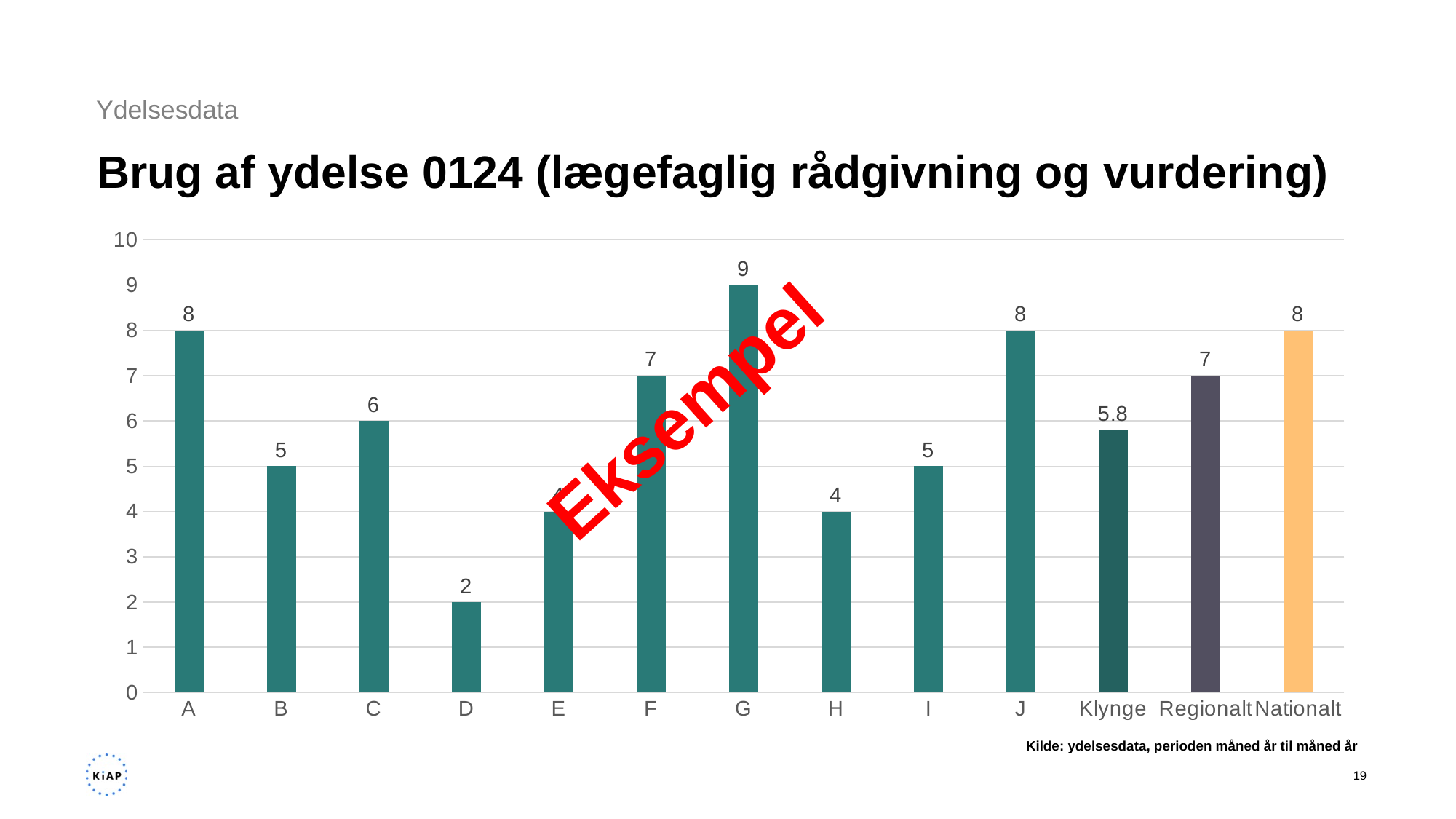
What is the value for G? 9 Is the value for E greater or less than 5? less Which category has the lowest value? D What is the difference between the values for J and Klynge? 2.2 How many categories are shown on the x axis? 13 Which is larger, the value for Regionalt or the value for Nationalt? Nationalt What is the difference between the values for G and D? 7 What kind of chart is shown on the slide? bar chart Which category has the highest value? G What is the title of the chart? Brug af ydelse 0124 (lægefaglig rådgivning og vurdering) What is the value for Klynge? 5.8 What is the value for Regionalt? 7